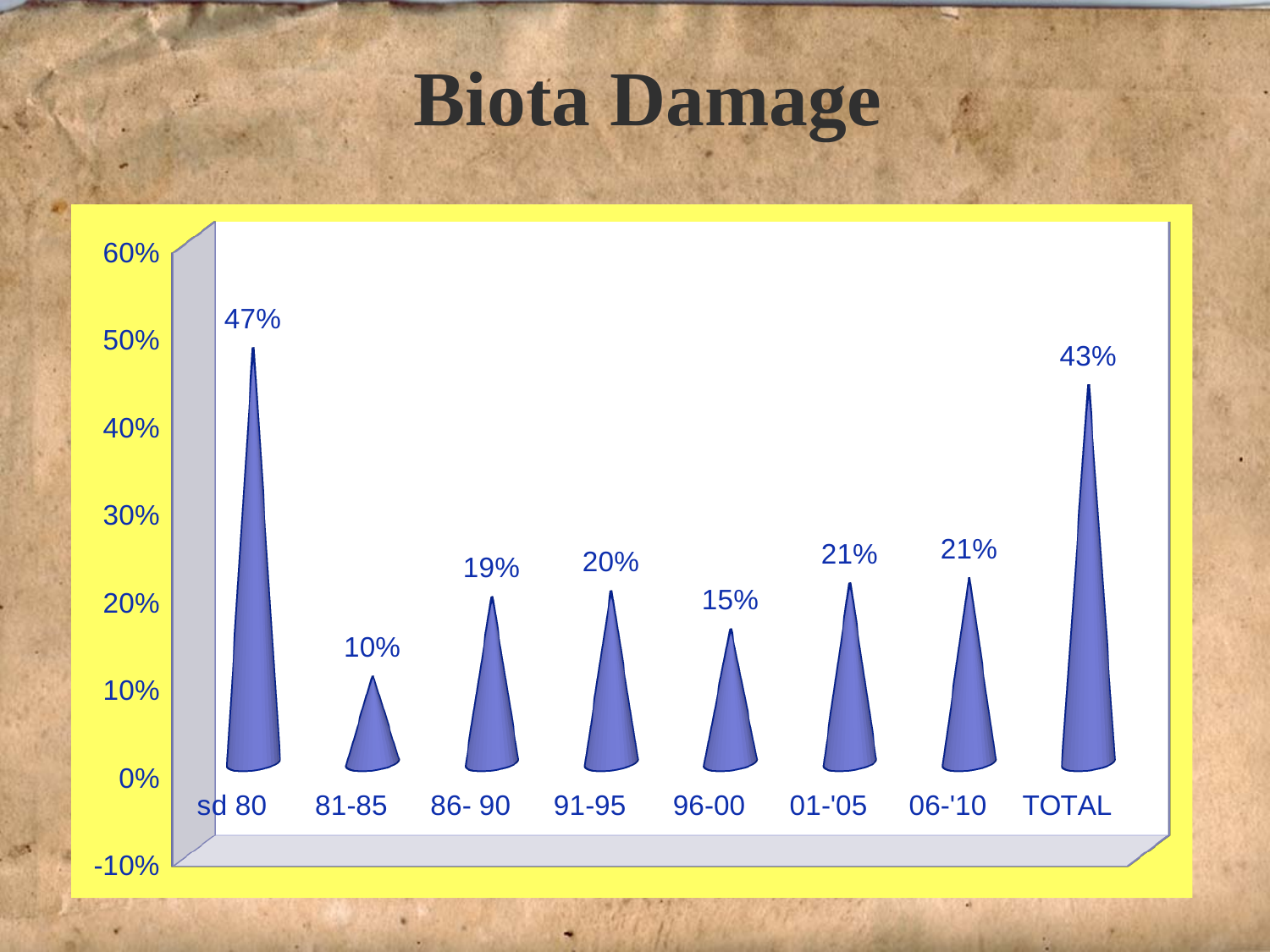
Which category has the lowest value? 81-85 How many categories are shown on the x axis? 8 What is the value for TOTAL? 43% What is the title of the slide? Biota Damage What is the value for 96-00? 15% What is the difference between the values for 91-95 and 96-00? 5% What is the value for sd 80? 47% Which is larger, the value for 86- 90 or the value for 96-00? 86- 90 What is the difference between the values for sd 80 and TOTAL? 4% What kind of chart is shown on the slide? bar chart Which category has the highest value? sd 80 What is the value for 81-85? 10%